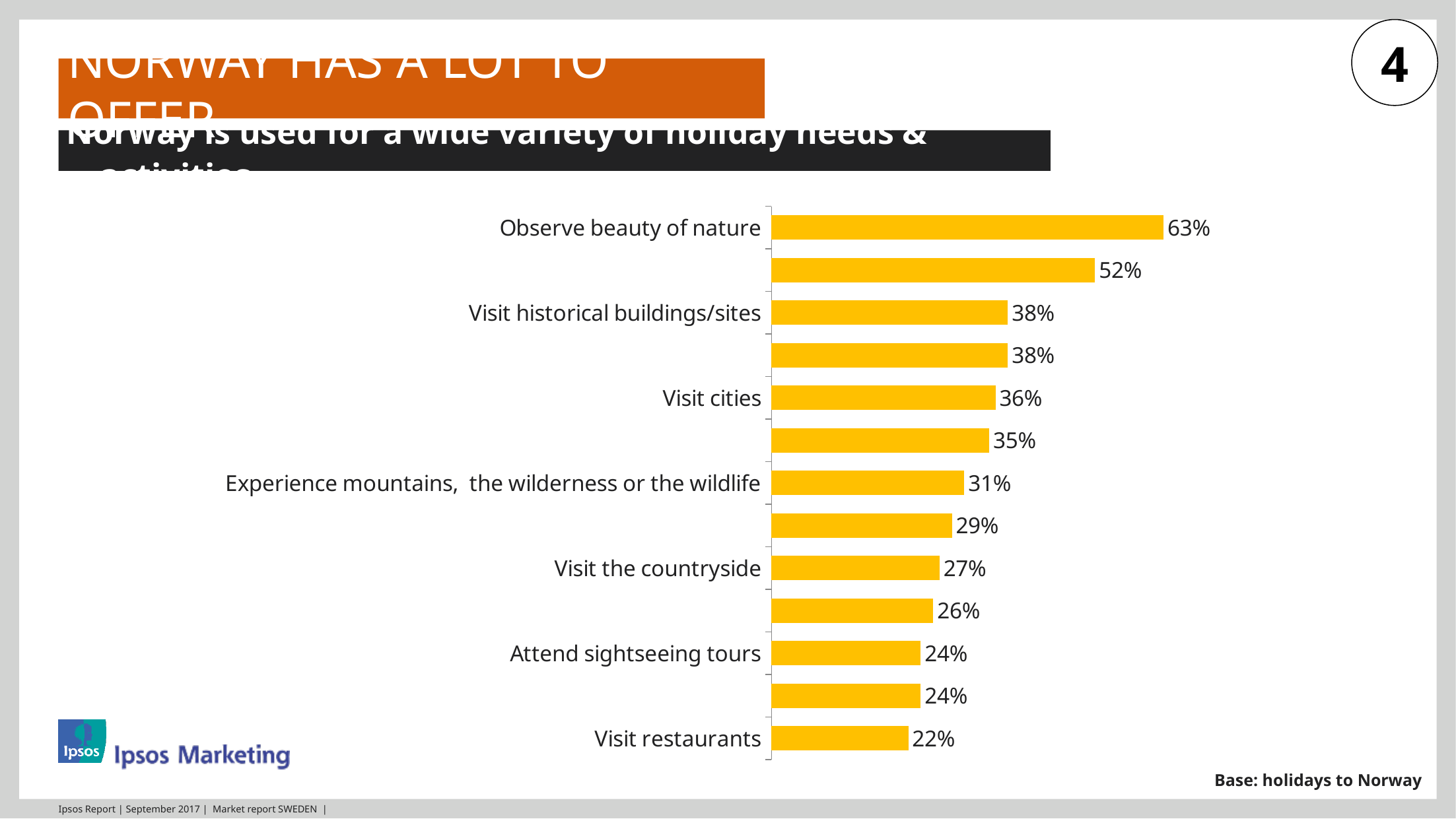
How many bars are plotted in the chart? 13 What percentage is shown for "Observe beauty of nature"? 63% What colour are the bars in the chart? Yellow Which activity has the highest percentage in the chart? Observe beauty of nature What type of chart is shown on the slide? Bar chart What percentage is shown for "Visit cities"? 36% What is the value for "Visit historical buildings/sites"? 38% What is the difference in percentage points between "Observe beauty of nature" and "Visit restaurants"? 41 percentage points Which activity has the lowest percentage in the chart? Visit restaurants What percentage is shown for "Visit restaurants"? 22% Which has a higher value, "Visit cities" or "Visit the countryside"? Visit cities What is the value for "Experience mountains, the wilderness or the wildlife"? 31%